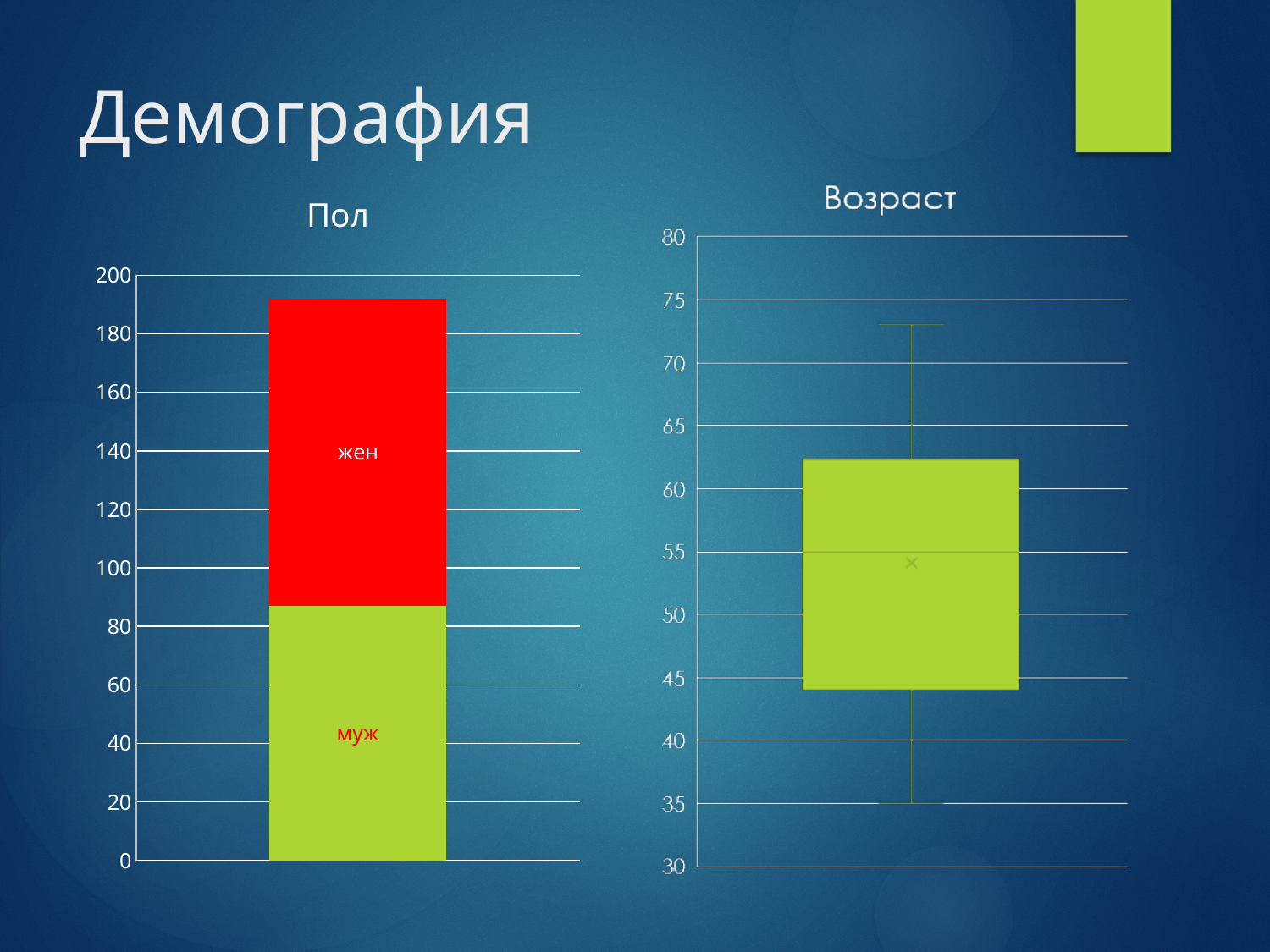
In the "Возраст" chart, is the top of the box greater or less than 60? greater In the "Возраст" chart, what is the highest value shown on the vertical axis? 80 What kind of chart is the "Пол" chart on the left? stacked bar chart In the "Пол" chart, how many segments make up the stacked bar? 2 In the "Пол" chart, which segment is larger, муж or жен? жен In the "Пол" chart, is the total height of the stacked bar greater or less than 200? less In the "Возраст" chart, is the lower whisker (minimum) greater or less than 40? less What kind of chart is the "Возраст" chart on the right? box plot In the "Пол" chart, what colour is the муж segment? green